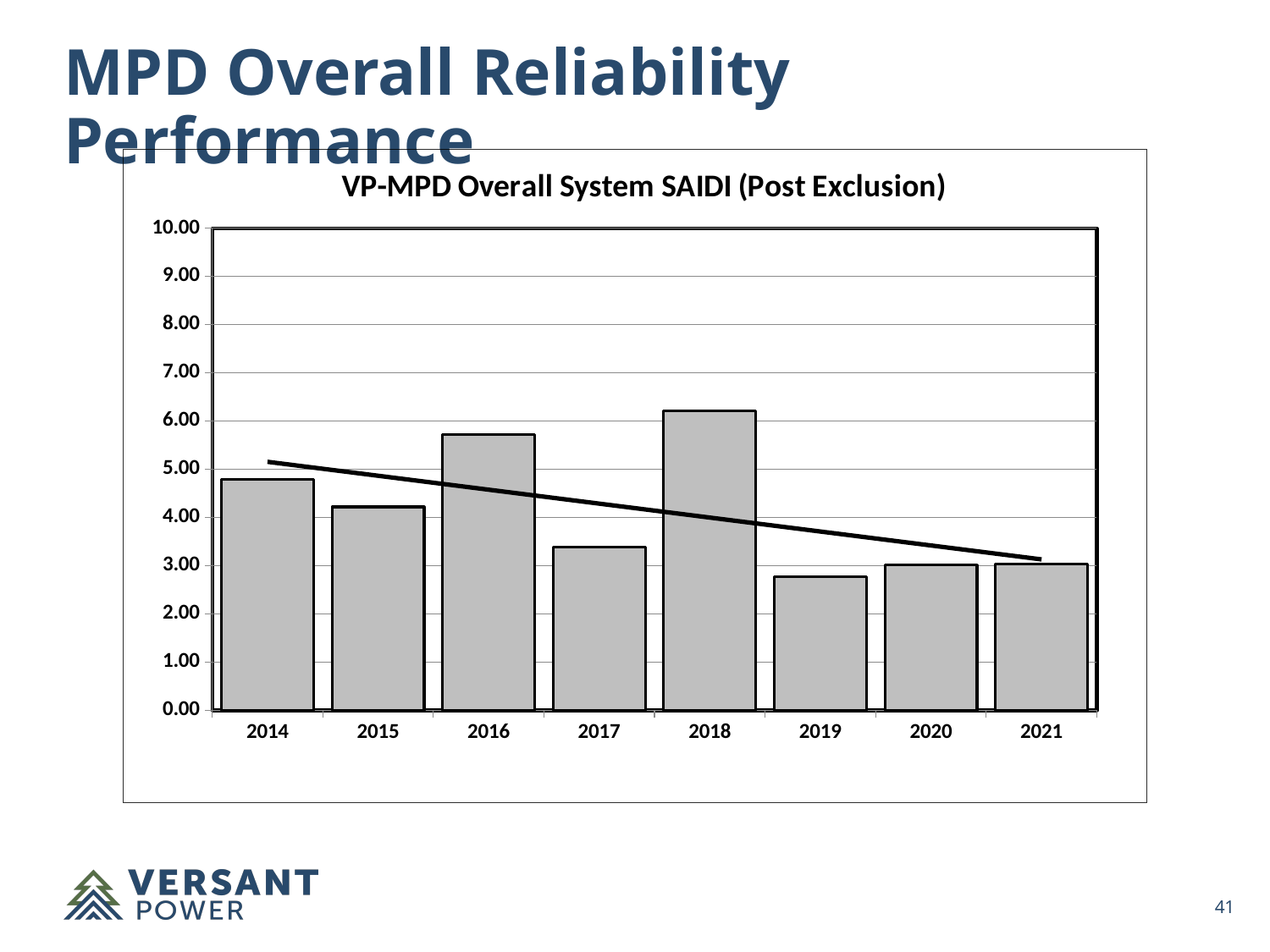
What kind of chart is shown on the slide? bar chart Is the value for 2017 greater or less than 4.00? less Which is larger, the value for 2016 or the value for 2017? 2016 Is the value for 2018 greater or less than 6.00? greater Which year has the highest SAIDI value? 2018 Is the value for 2019 greater or less than 3.00? less How many years are shown on the x axis of the chart? 8 Does the trend line on the chart rise or fall from 2014 to 2021? fall What is the title of the chart? VP-MPD Overall System SAIDI (Post Exclusion) Which is larger, the value for 2014 or the value for 2015? 2014